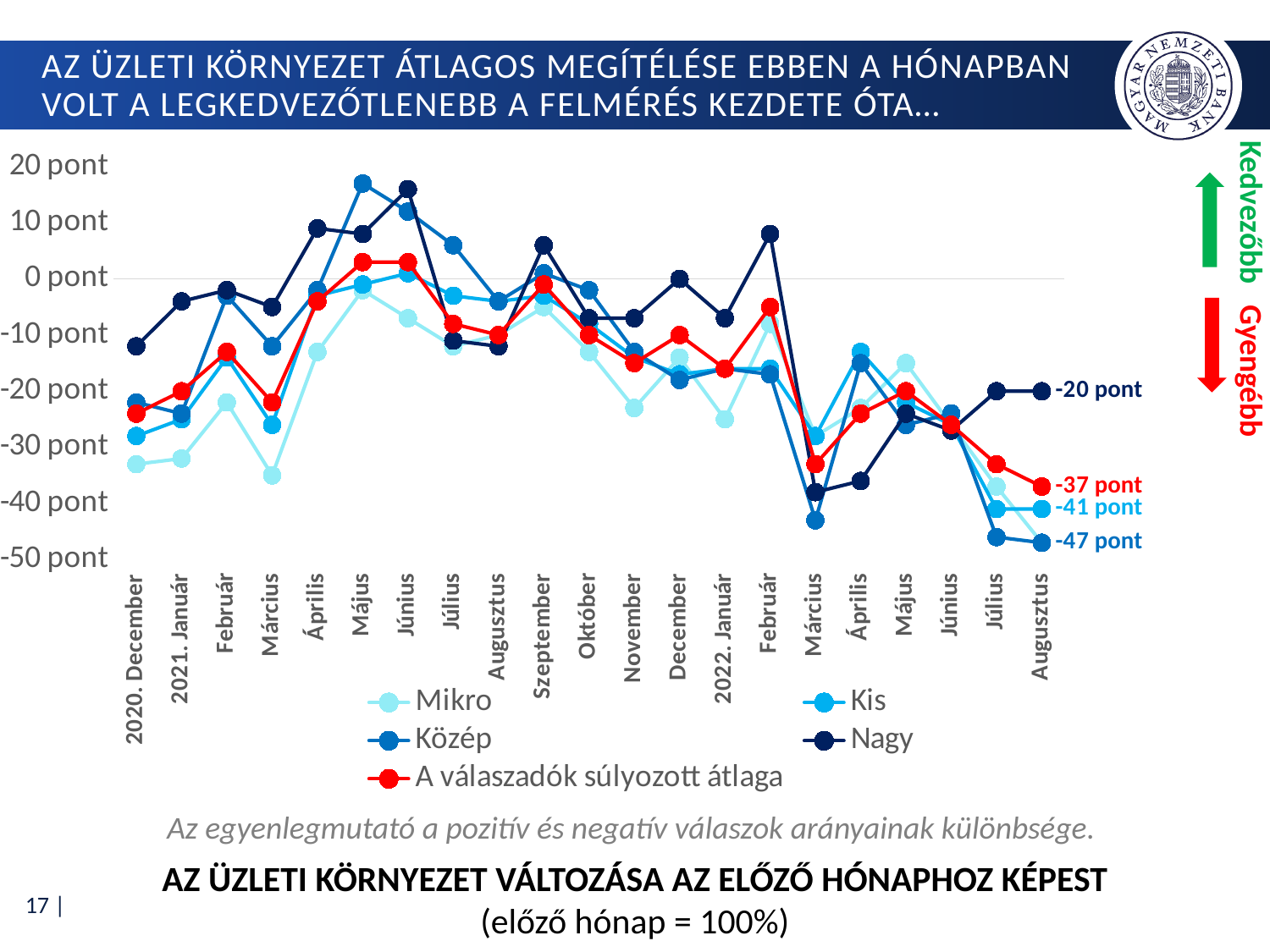
What is the difference between the Nagy value and the Közép value in Augusztus (2022)? 27 pont What is the value for Nagy in Augusztus (2022)? -20 pont In Augusztus (2022), which is higher: Nagy or Kis? Nagy What is the difference between the Nagy value and the weighted average ('A válaszadók súlyozott átlaga') in Augusztus (2022)? 17 pont What is the value for Közép in Augusztus (2022)? -47 pont What is the value for Kis in Augusztus (2022)? -41 pont Is the value for Nagy in Május 2021 greater or less than 0 pont? greater How many months (points) are shown on the x axis? 21 How many series does the legend list? 5 Is the value for Mikro in Március 2021 greater or less than -30 pont? less What is the value for 'A válaszadók súlyozott átlaga' in Augusztus (2022)? -37 pont What kind of chart is shown on the slide? line chart